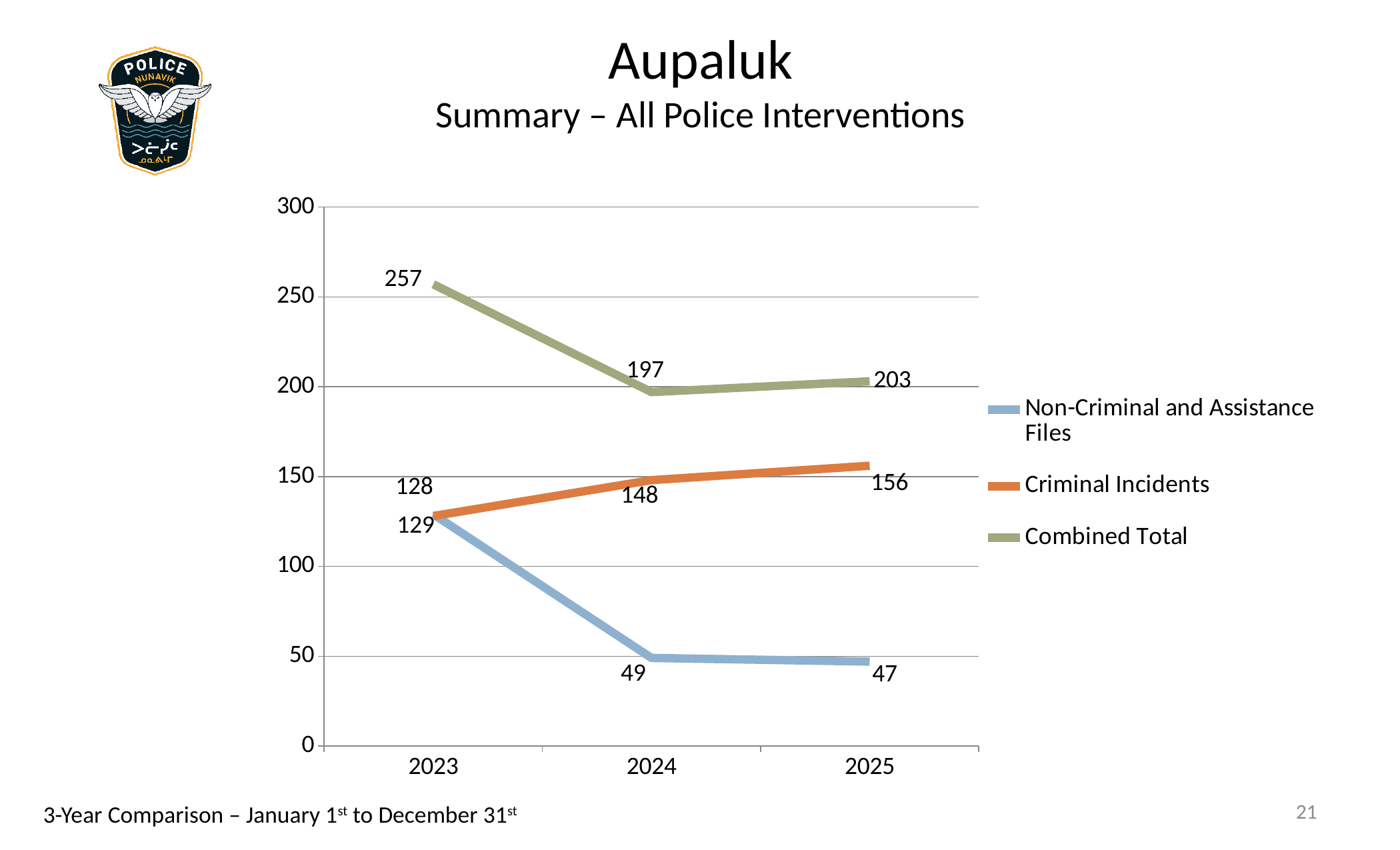
Does the Criminal Incidents series rise or fall from 2023 to 2025? rise What is the Non-Criminal and Assistance Files value for 2024? 49 How many years are shown on the x axis? 3 What is the Combined Total value for 2023? 257 What is the difference between the Combined Total in 2023 and in 2024? 60 In which year is the Combined Total highest? 2023 What type of chart is shown on the slide? line chart In which year is the Non-Criminal and Assistance Files value lowest? 2025 What is the Criminal Incidents value for 2025? 156 What is the Combined Total value for 2025? 203 How many series does the legend list? 3 Which is larger in 2025: Criminal Incidents or Non-Criminal and Assistance Files? Criminal Incidents